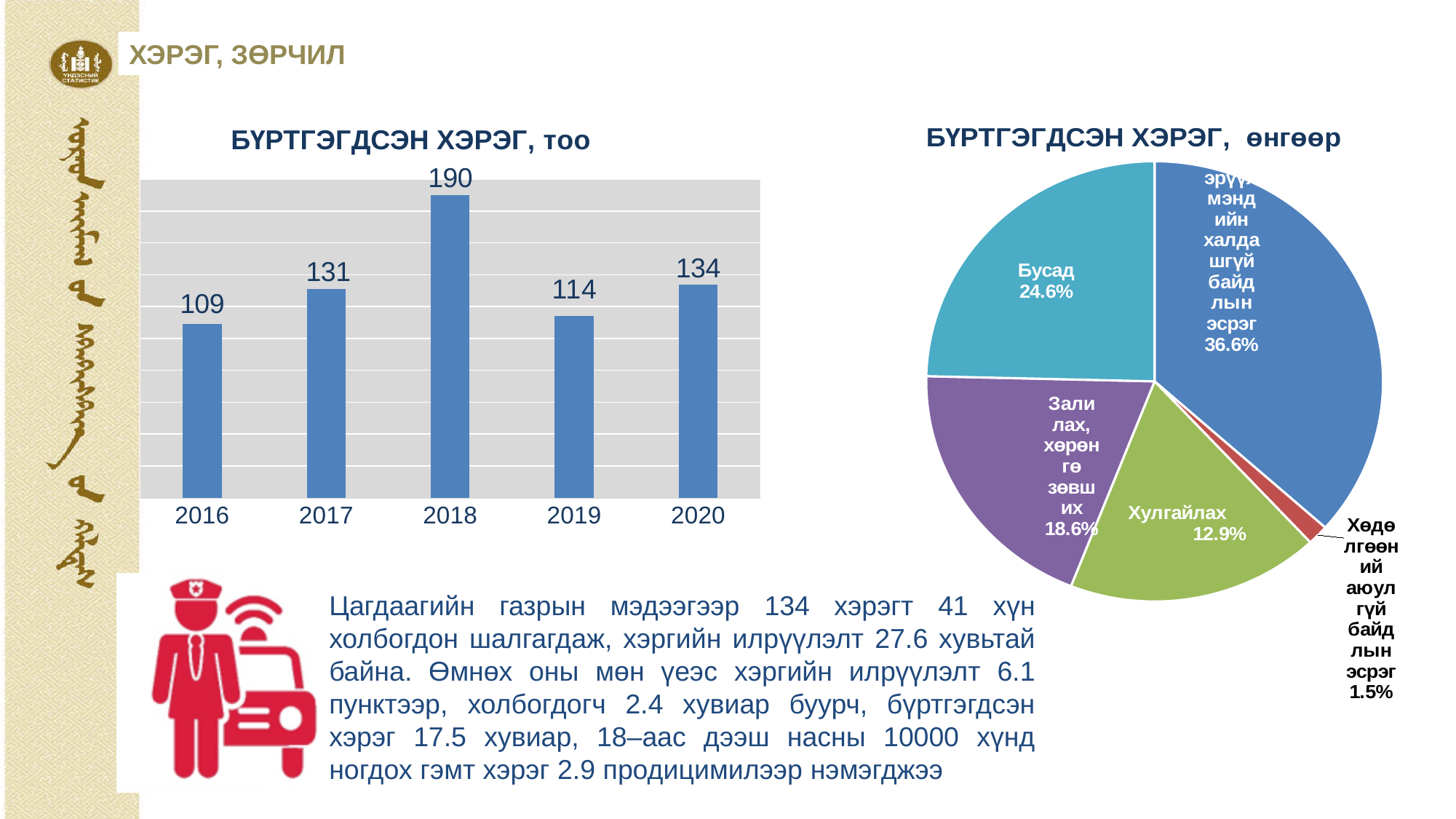
In the pie chart 'БҮРТГЭГДСЭН ХЭРЭГ, өнгөөр', which slice is the smallest? Хөдөлгөөний аюулгүй байдлын эсрэг How many slices does the pie chart 'БҮРТГЭГДСЭН ХЭРЭГ, өнгөөр' have? 5 In the bar chart 'БҮРТГЭГДСЭН ХЭРЭГ, тоо', which year has the highest value? 2018 In the bar chart 'БҮРТГЭГДСЭН ХЭРЭГ, тоо', which is larger, the value for 2017 or the value for 2020? 2020 In the bar chart 'БҮРТГЭГДСЭН ХЭРЭГ, тоо', what is the value for 2018? 190 What kind of chart is 'БҮРТГЭГДСЭН ХЭРЭГ, тоо'? bar chart In the bar chart 'БҮРТГЭГДСЭН ХЭРЭГ, тоо', what is the difference between the values for 2018 and 2019? 76 How many years are shown in the bar chart 'БҮРТГЭГДСЭН ХЭРЭГ, тоо'? 5 In the pie chart 'БҮРТГЭГДСЭН ХЭРЭГ, өнгөөр', what share does 'Хулгайлах' have? 12.9% In the bar chart 'БҮРТГЭГДСЭН ХЭРЭГ, тоо', which year has the lowest value? 2016 In the pie chart 'БҮРТГЭГДСЭН ХЭРЭГ, өнгөөр', what share does 'Бусад' have? 24.6% In the bar chart 'БҮРТГЭГДСЭН ХЭРЭГ, тоо', what is the value for 2016? 109